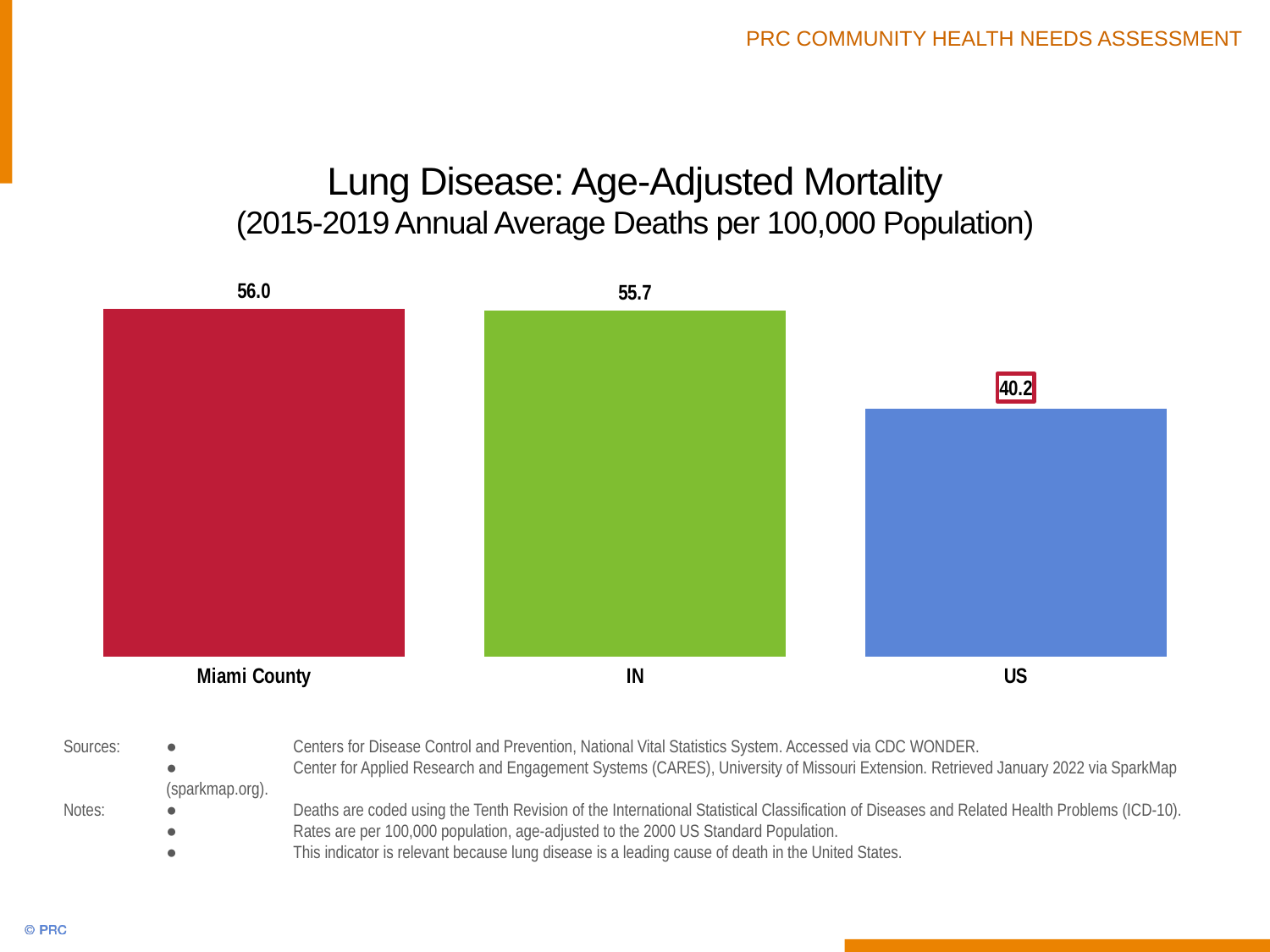
What is the difference between the Miami County rate and the US rate? 15.8 How many categories are shown in the chart? 3 What is the difference between the IN rate and the US rate? 15.5 Which is larger, the rate for IN or the rate for the US? IN What is the lung disease age-adjusted mortality rate for IN? 55.7 What colour is the bar for the US? Blue What is the lung disease age-adjusted mortality rate for the US? 40.2 Which category has the lowest lung disease age-adjusted mortality rate? US What kind of chart is shown on the slide? Bar chart What is the title of the chart? Lung Disease: Age-Adjusted Mortality What is the lung disease age-adjusted mortality rate for Miami County? 56.0